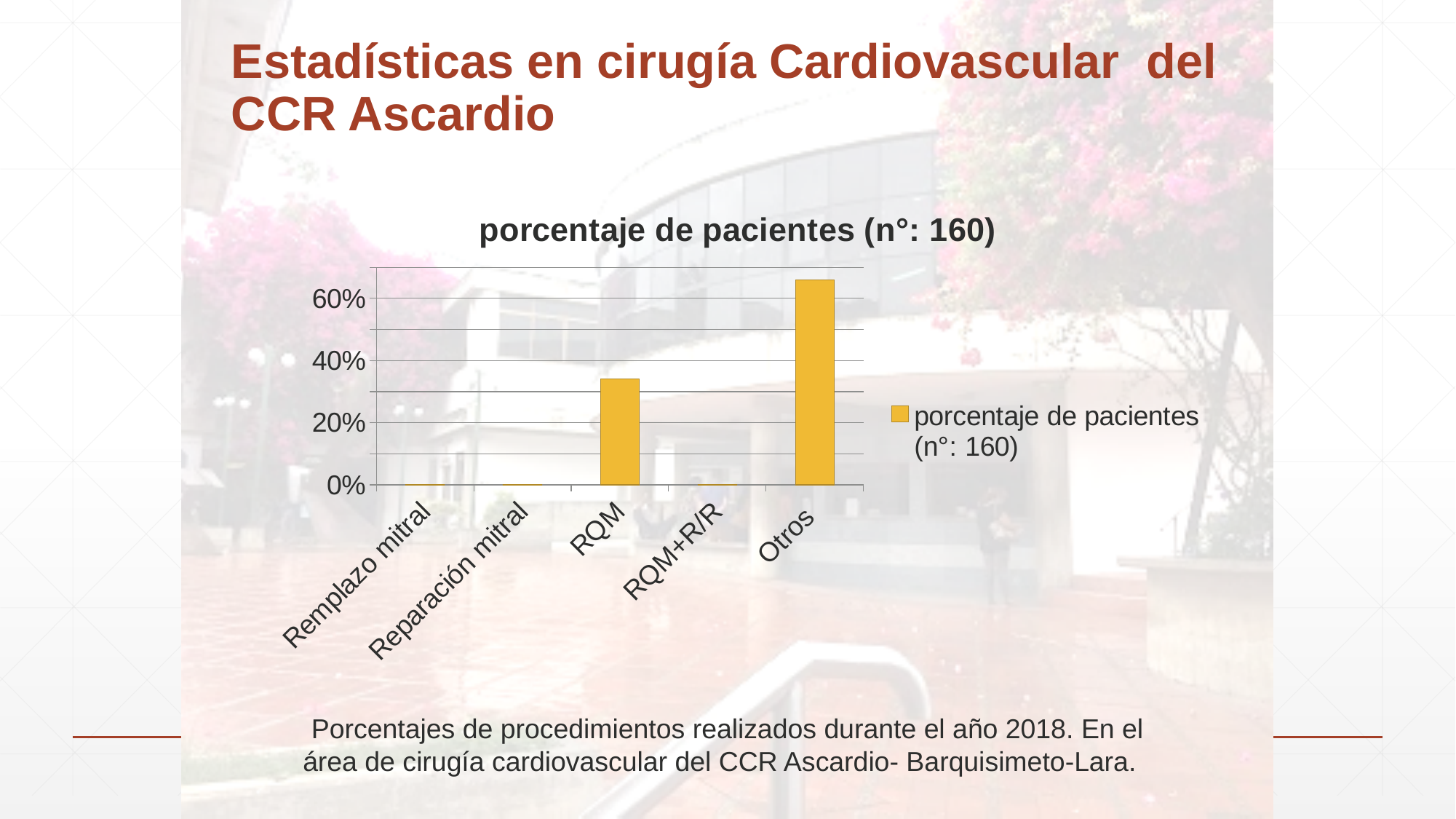
How many categories are shown on the x axis of the chart? 5 What is the title of the chart? porcentaje de pacientes (n°: 160) Is the value for Otros greater or less than 60%? greater Is the value for RQM greater or less than 40%? less How many series does the chart legend list? 1 Which category has the highest value in the chart? Otros Is the value for RQM+R/R greater or less than 20%? less What is the name of the series shown in the chart legend? porcentaje de pacientes (n°: 160) Which is larger, the value for RQM or the value for Otros? Otros What kind of chart is shown on the slide? bar chart